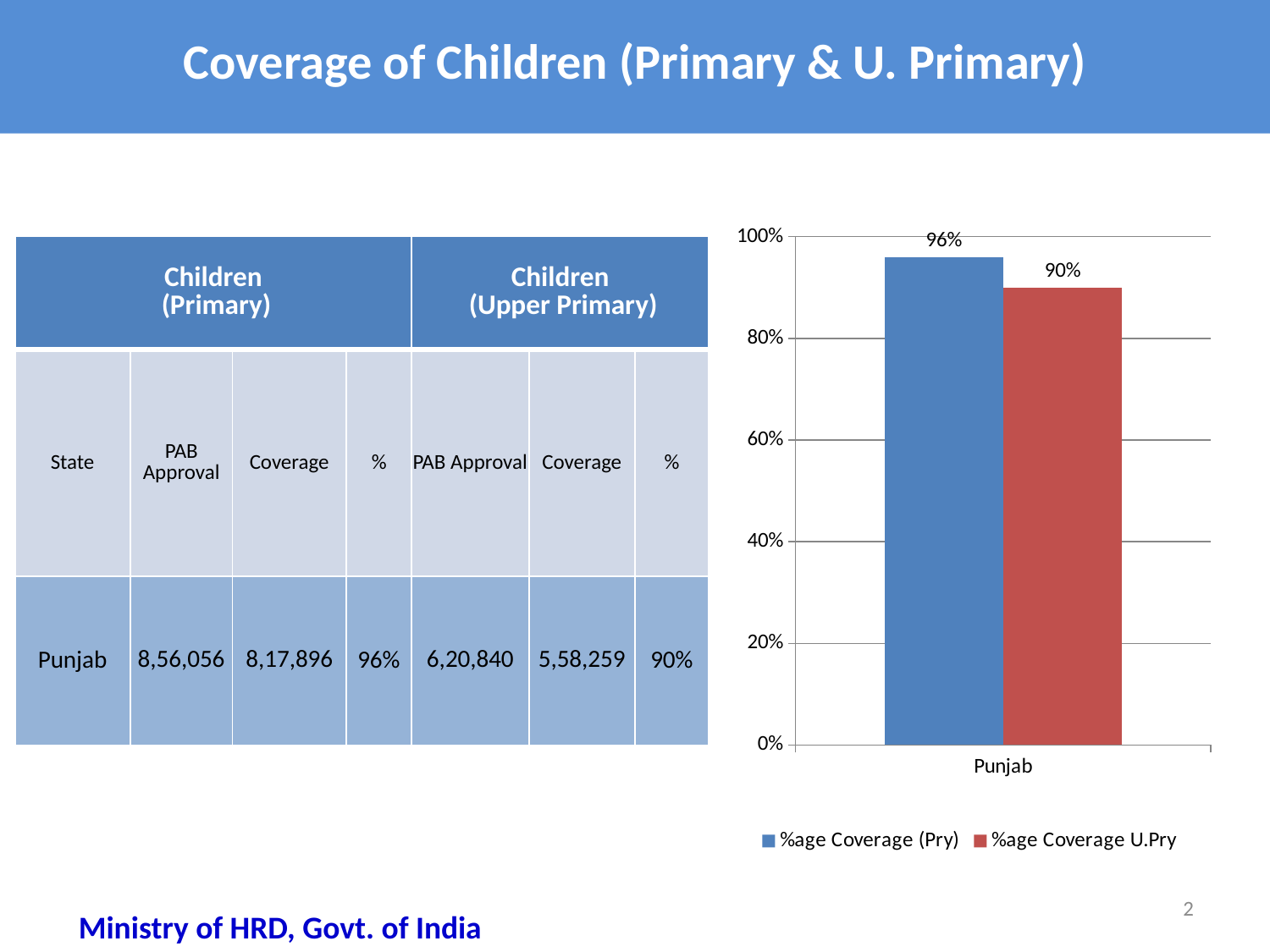
Which series has the lowest value in the chart? %age Coverage U.Pry What colour is the bar for %age Coverage U.Pry? Red What is the value of %age Coverage U.Pry for Punjab? 90% Is the value for %age Coverage (Pry) for Punjab greater or less than 100%? less What is the difference between %age Coverage (Pry) and %age Coverage U.Pry for Punjab? 6% How many series does the chart legend list? 2 Which category is shown on the x axis of the chart? Punjab Which series has the higher value for Punjab, %age Coverage (Pry) or %age Coverage U.Pry? %age Coverage (Pry) How many categories are shown on the x axis of the chart? 1 What is the value of %age Coverage (Pry) for Punjab? 96% Is the value for %age Coverage U.Pry for Punjab greater or less than 80%? greater What kind of chart is shown on the slide? Bar chart